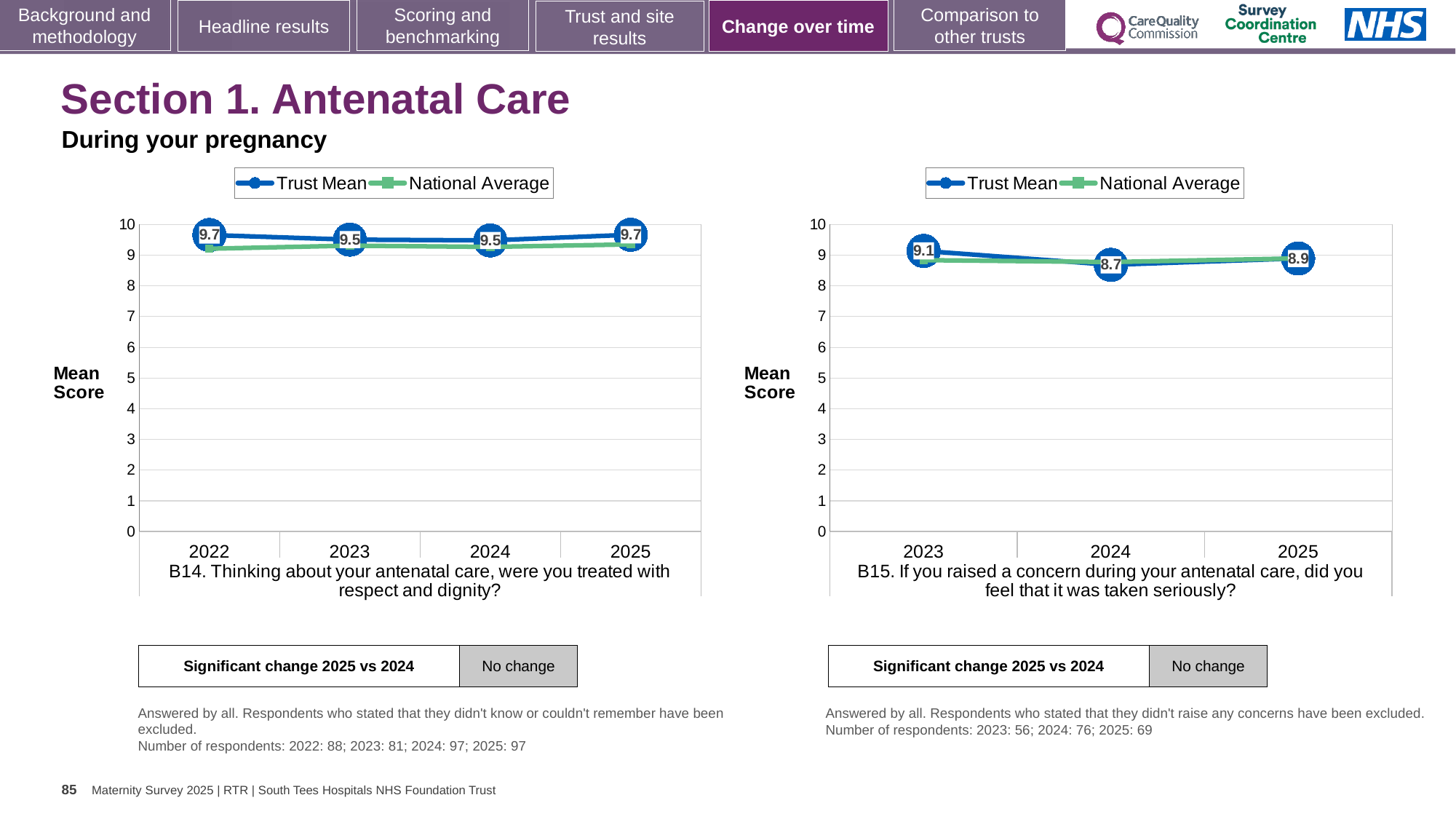
In the B15 chart (right), which year has the highest Trust Mean? 2023 How many series does the legend of the B15 chart (right) list? 2 In the B15 chart (right), what is the difference between the Trust Mean in 2023 and in 2024? 0.4 In the B14 chart (left), what is the Trust Mean for 2024? 9.5 What type of chart is the B14 chart (left)? Line chart How many years are plotted on the x axis of the B14 chart (left)? 4 In the B14 chart (left), what is the difference between the Trust Mean in 2025 and in 2024? 0.2 In the B15 chart (right), what is the Trust Mean for 2025? 8.9 In the B14 chart (left), what is the Trust Mean for 2022? 9.7 In the B15 chart (right), what is the Trust Mean for 2024? 8.7 In the B15 chart (right), which year has the lowest Trust Mean? 2024 In the B15 chart (right), is the Trust Mean higher in 2023 or in 2024? 2023